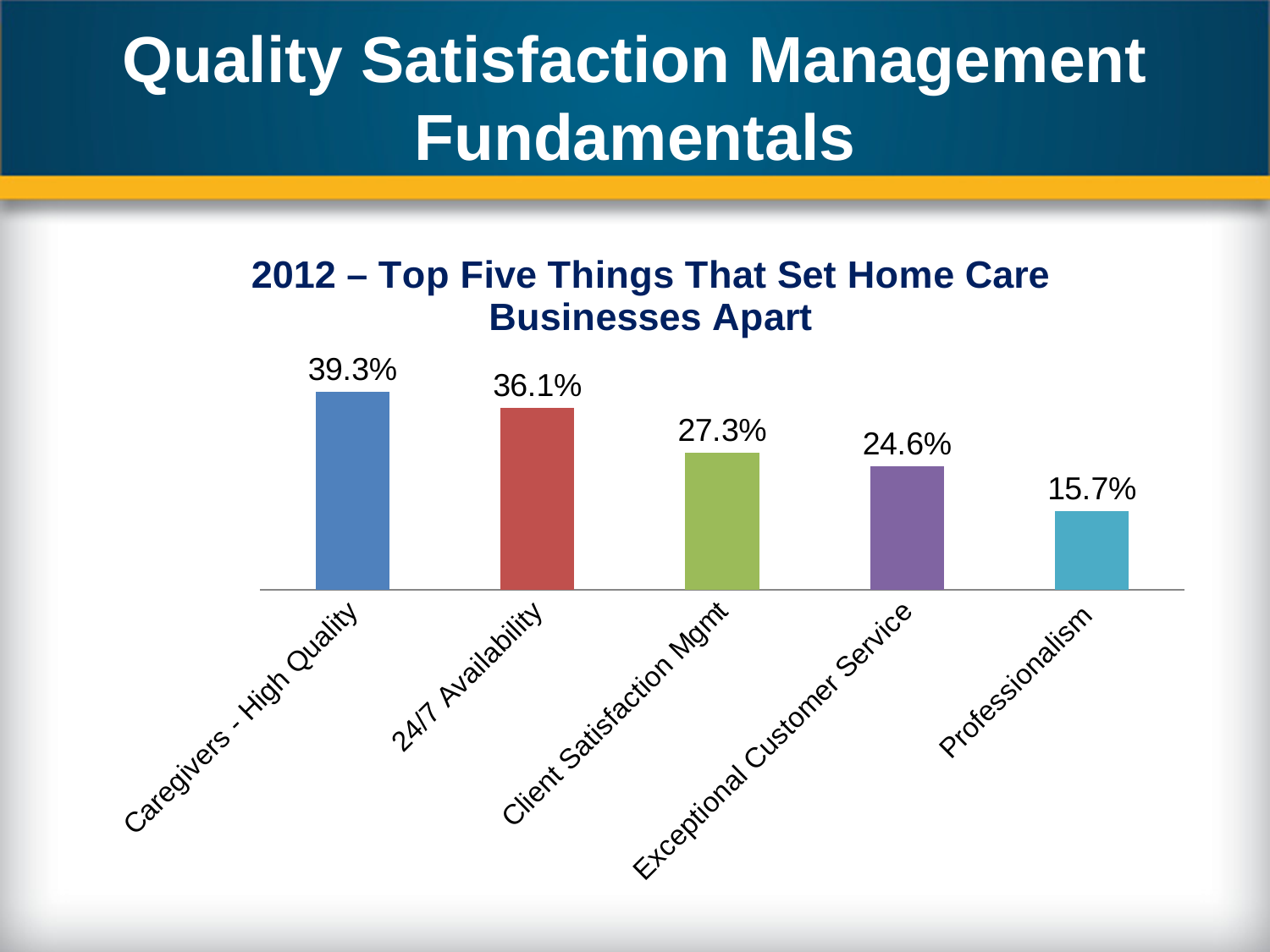
What is the difference between the values for Caregivers - High Quality and 24/7 Availability? 3.2% What is the value for Caregivers - High Quality? 39.3% Which category has the highest value? Caregivers - High Quality What is the value for 24/7 Availability? 36.1% What is the value for Client Satisfaction Mgmt? 27.3% Which is larger, the value for Client Satisfaction Mgmt or Exceptional Customer Service? Client Satisfaction Mgmt What is the value for Professionalism? 15.7% How many categories are shown in the chart? 5 What is the title of the chart? 2012 – Top Five Things That Set Home Care Businesses Apart What is the value for Exceptional Customer Service? 24.6% What kind of chart is shown on the slide? Bar chart Which category has the lowest value? Professionalism